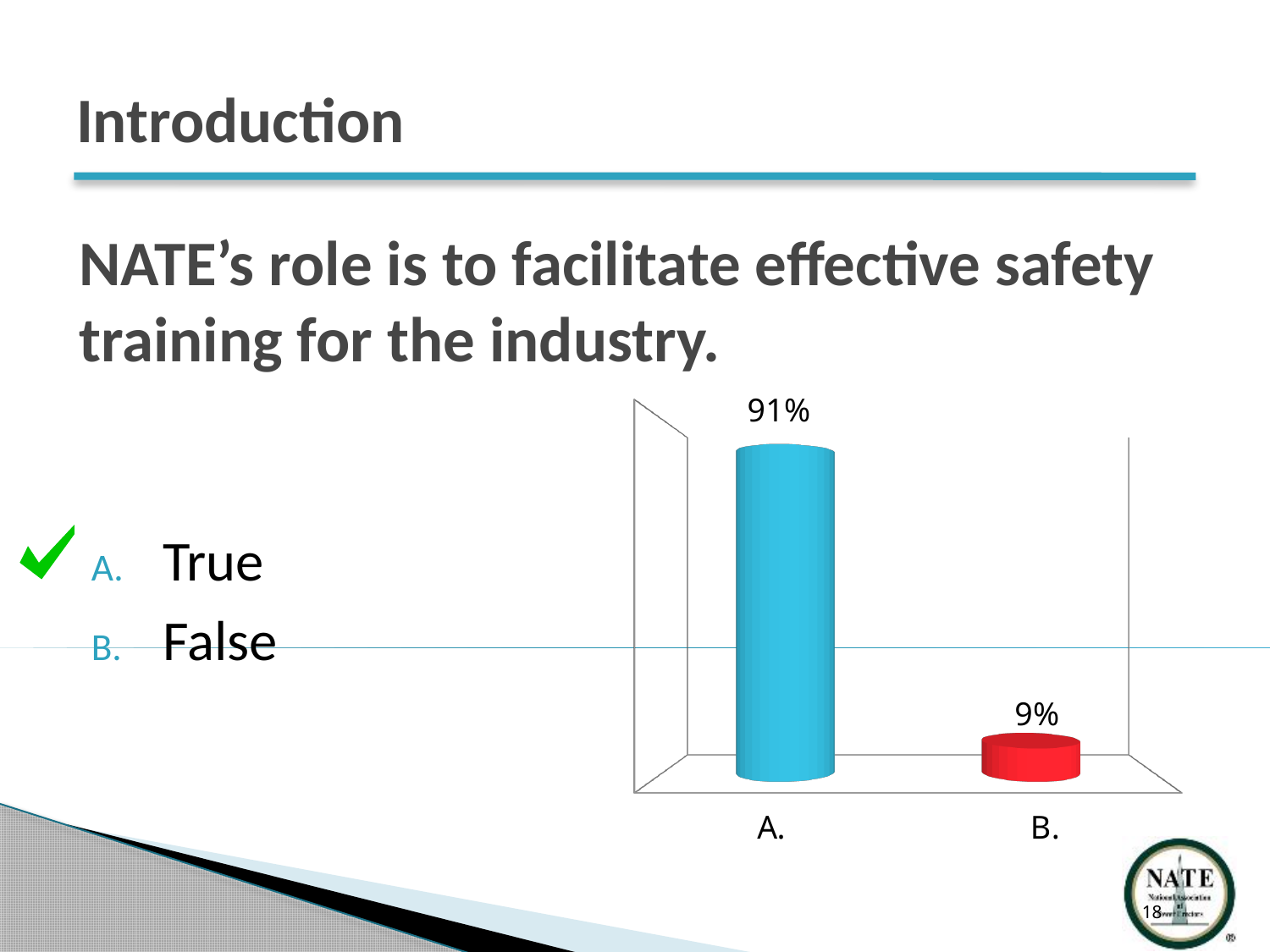
Which category has the larger value, A. or B.? A. What colour is the bar for category B.? red What is the value for category A. in the chart? 91% What is the difference between the values for A. and B.? 82% What kind of chart is shown on the slide? bar chart What is the total of the values for A. and B.? 100% What is the value for category B. in the chart? 9% Which category has the lowest value in the chart? B. How many categories are shown in the chart? 2 What colour is the bar for category A.? blue Which category has the highest value in the chart? A.